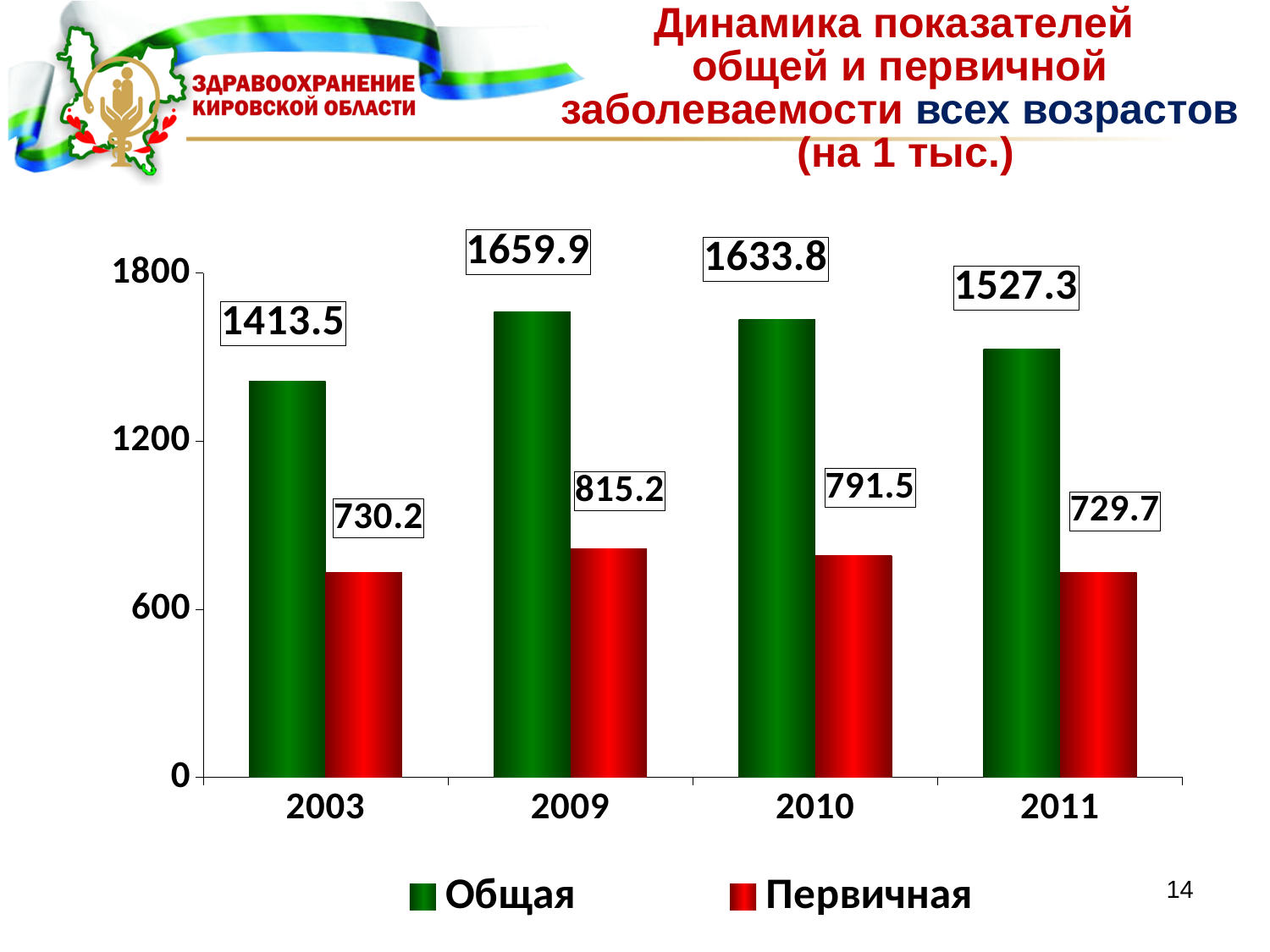
What type of chart is shown on the slide? bar chart In which year is Общая the lowest? 2003 What is the difference between Общая and Первичная in 2010? 842.3 In which year is Первичная the highest? 2009 What is the value of Общая for 2003? 1413.5 What is the value of Общая for 2009? 1659.9 How many series does the legend list? 2 What is the value of Первичная for 2011? 729.7 How many years are shown on the x axis? 4 In which year is Общая the highest? 2009 Which is larger: Первичная in 2009 or Первичная in 2010? Первичная in 2009 What is the difference between Общая in 2009 and Общая in 2003? 246.4